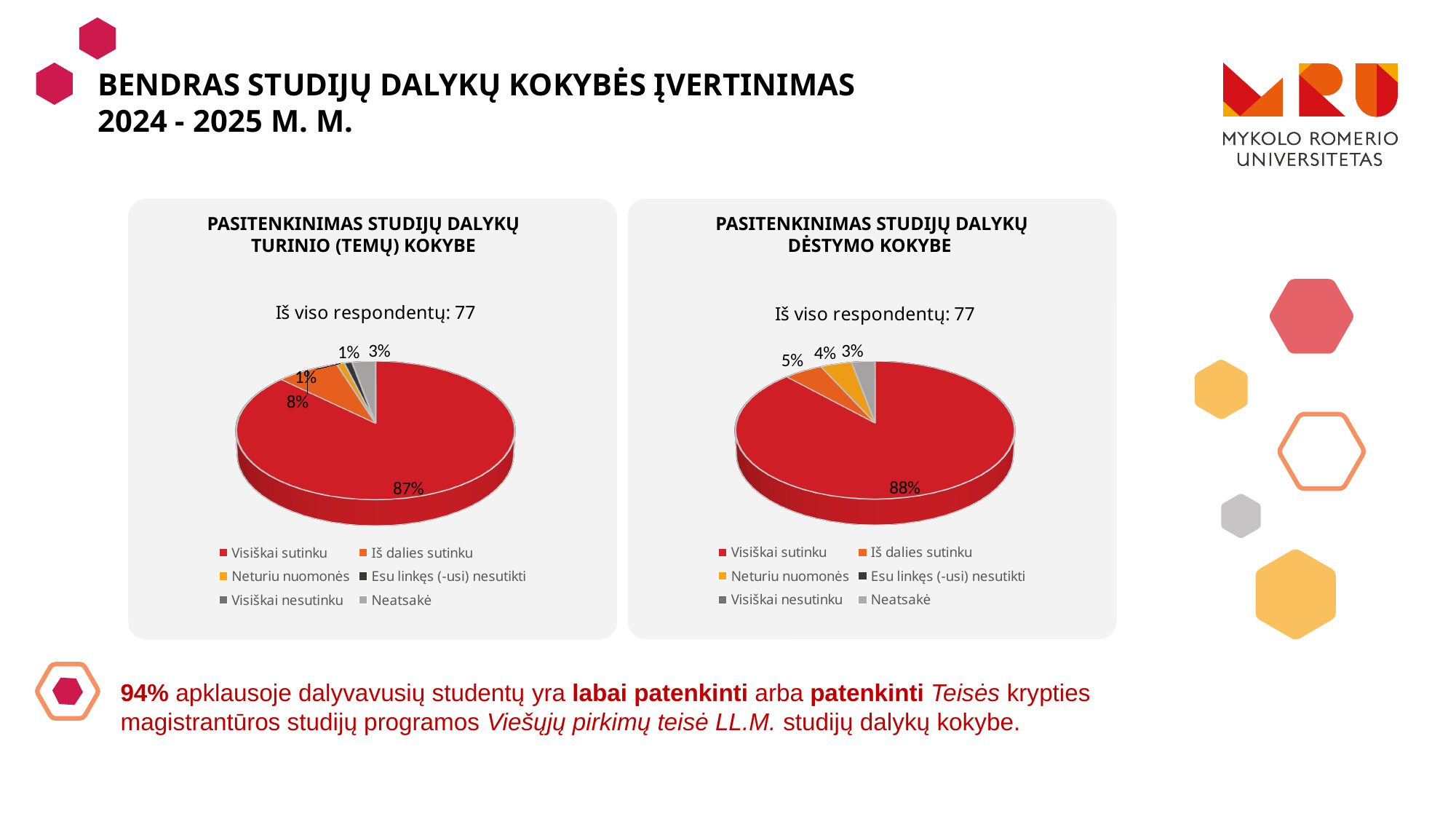
In the left chart, what percentage is shown for 'Iš dalies sutinku'? 8% In the right chart (Pasitenkinimas studijų dalykų dėstymo kokybe), what share of respondents answered 'Visiškai sutinku'? 88% In the right chart, what percentage is shown for 'Neatsakė'? 3% In the right chart, what percentage is shown for 'Neturiu nuomonės'? 4% How many respondents are reported for the right chart (Iš viso respondentų)? 77 In the left chart (Pasitenkinimas studijų dalykų turinio (temų) kokybe), what share of respondents answered 'Visiškai sutinku'? 87% Which chart has the larger 'Iš dalies sutinku' share, the left chart or the right chart? The left chart How many entries does the legend of the left chart list? 6 What is the difference between the 'Visiškai sutinku' share in the right chart and in the left chart? 1% In the right chart, what percentage is shown for 'Iš dalies sutinku'? 5% What type of chart is used on this slide? Pie chart In the left chart, which category has the largest slice? Visiškai sutinku